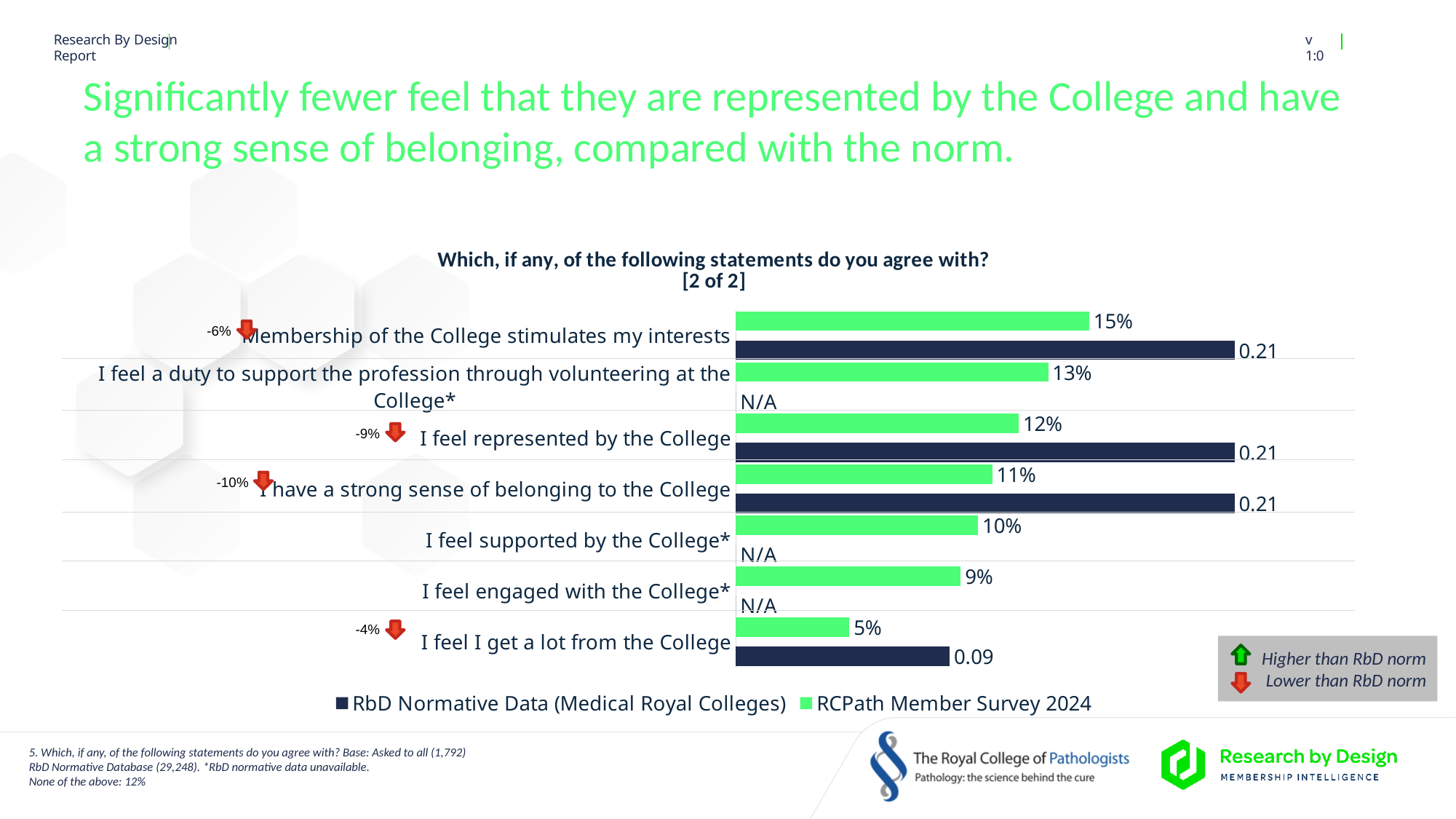
What is the RCPath Member Survey 2024 value for "I feel a duty to support the profession through volunteering at the College*"? 13% How many series does the chart legend list? 2 What is the RCPath Member Survey 2024 value for "Membership of the College stimulates my interests"? 15% How many statements (categories) are shown in the chart? 7 Which is larger for "I have a strong sense of belonging to the College": the RCPath Member Survey 2024 value or the RbD Normative Data value? RbD Normative Data What kind of chart is shown on the slide? bar chart What is the RbD Normative Data value shown for "I feel engaged with the College*"? N/A What is the difference between the RCPath Member Survey 2024 values for "I feel supported by the College*" and "I feel I get a lot from the College"? 5% What is the RbD Normative Data value for "I feel represented by the College"? 0.21 Which statement has the lowest RCPath Member Survey 2024 value? I feel I get a lot from the College What is the RbD Normative Data value for "I feel I get a lot from the College"? 0.09 Which statement has the highest RCPath Member Survey 2024 value? Membership of the College stimulates my interests